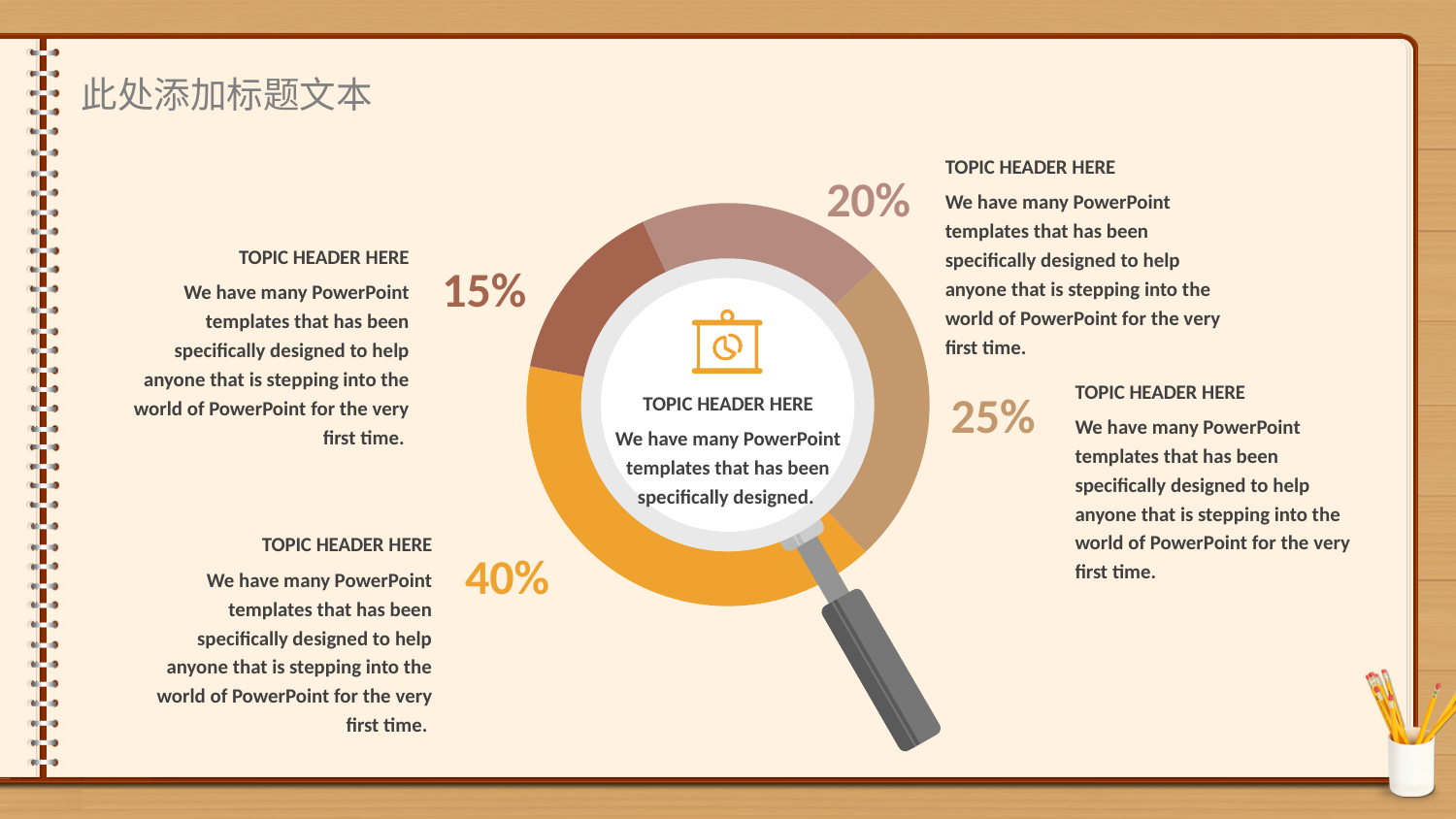
What percentage is labelled on the orange segment of the donut chart? 40% What is the smallest percentage shown on the donut chart? 15% What percentage is labelled on the dark brown segment at the upper left of the donut chart? 15% What share of the donut does the segment at the right side (tan colour) represent? 25% Is the value of the top (mauve) segment greater or less than 25%? less What kind of chart is shown on the slide? donut chart What do the four percentages on the donut chart add up to? 100% How many segments does the donut chart have? 4 Which is larger, the 20% segment or the 25% segment? 25% What header text is printed in the centre of the donut chart? TOPIC HEADER HERE What is the difference between the largest and smallest percentages on the donut chart? 25 percentage points What is the largest percentage shown on the donut chart? 40%